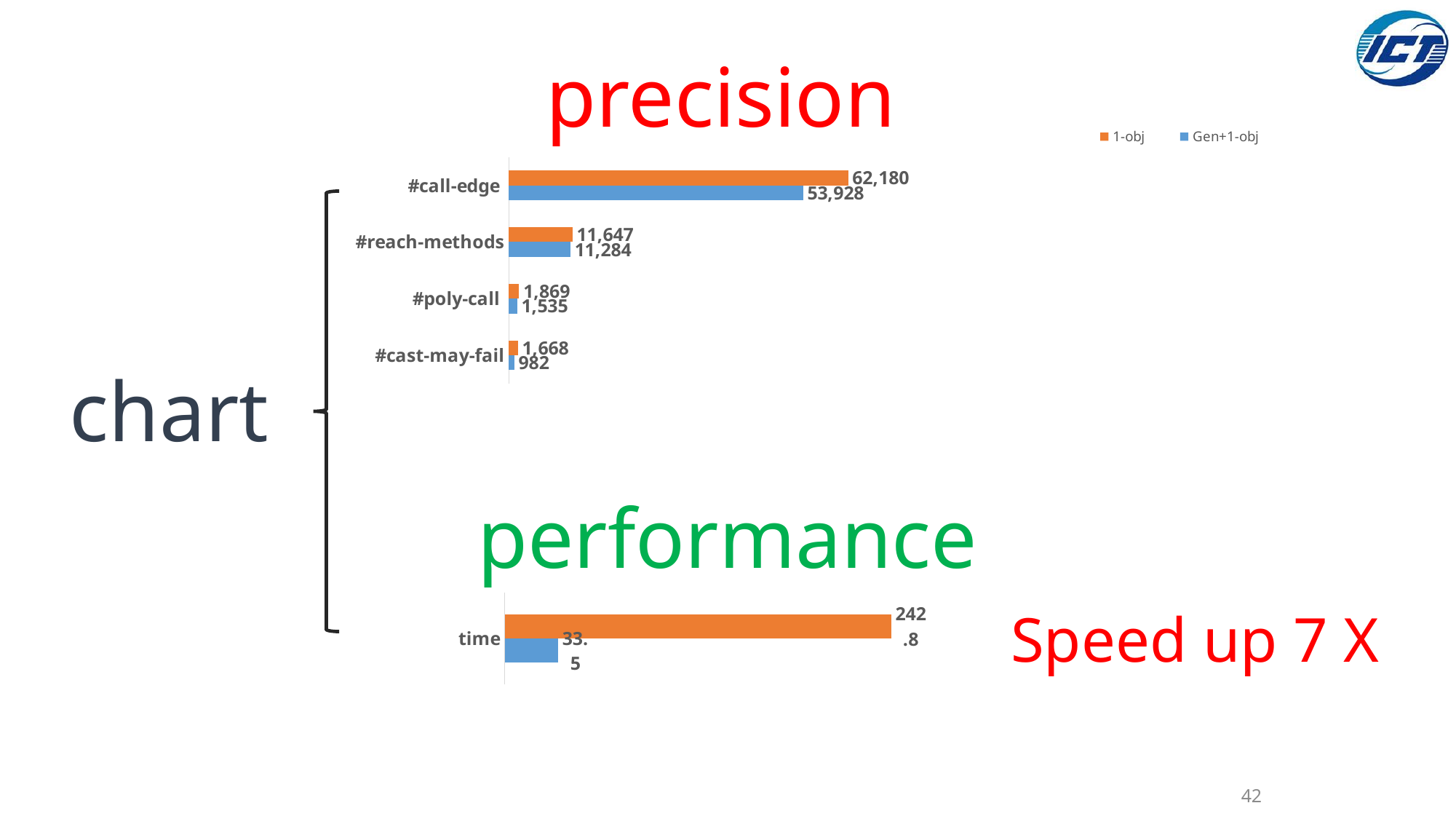
How many series does the legend of the precision chart list? 2 In the precision chart, what is the Gen+1-obj value for #reach-methods? 11,284 In the precision chart, which is larger for #reach-methods: the 1-obj value or the Gen+1-obj value? 1-obj In the precision chart, what is the Gen+1-obj value for #poly-call? 1,535 In the precision chart, what is the 1-obj value for #cast-may-fail? 1,668 In the precision chart, what is the difference between the 1-obj and Gen+1-obj values for #call-edge? 8,252 How many categories does the precision chart show? 4 In the precision chart, which category has the highest 1-obj value? #call-edge What type of chart is the performance chart at the bottom of the slide? Bar chart In the precision chart, what is the 1-obj value for #call-edge? 62,180 In the precision chart, what is the Gen+1-obj value for #call-edge? 53,928 In the precision chart, which category has the lowest Gen+1-obj value? #cast-may-fail